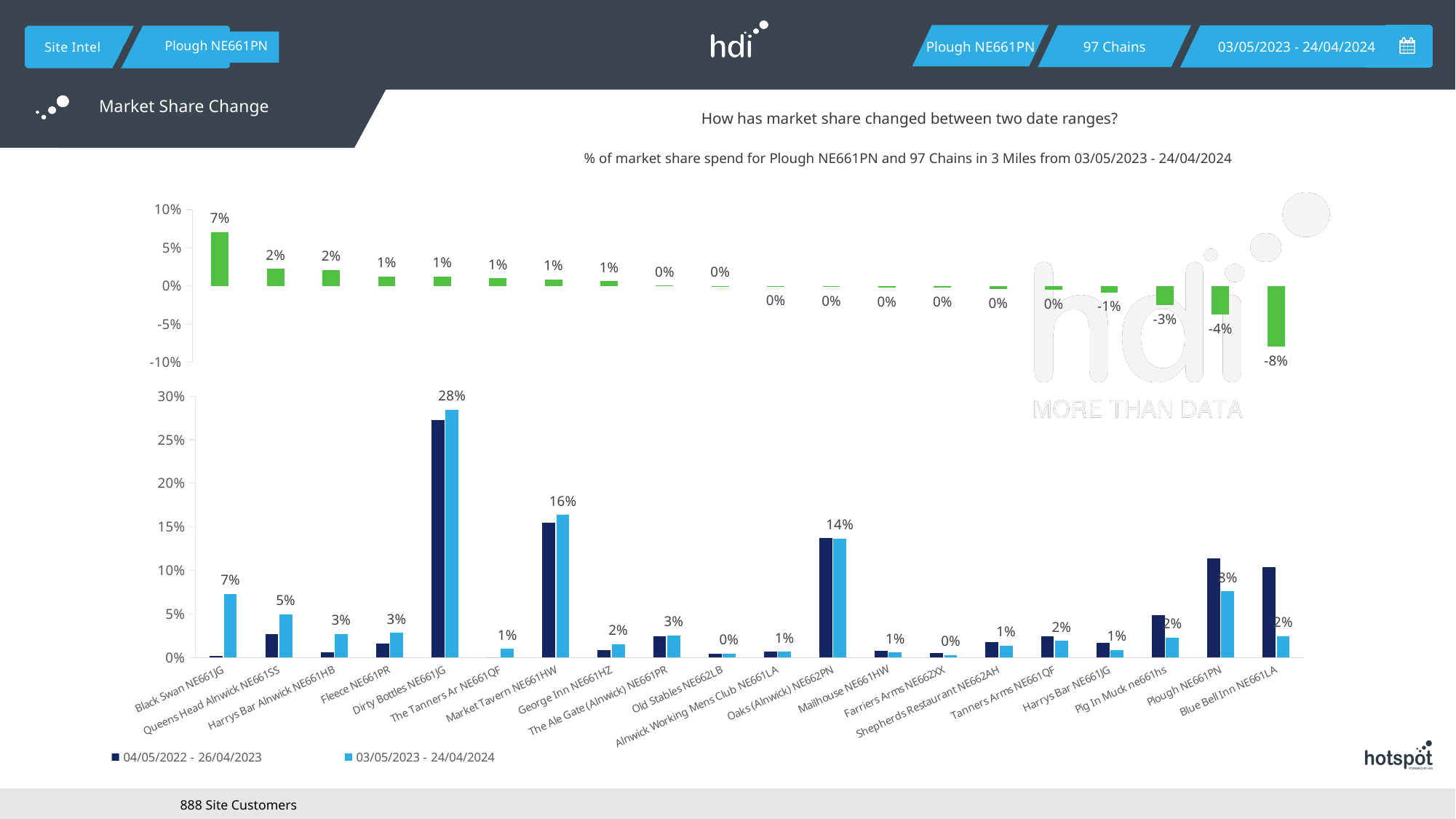
In the bottom chart, is the 04/05/2022 - 26/04/2023 value for Plough NE661PN greater or less than 10%? greater In the top chart, what is the value of the leftmost bar? 7% In the bottom chart, which is larger for Plough NE661PN: the 04/05/2022 - 26/04/2023 value or the 03/05/2023 - 24/04/2024 value? 04/05/2022 - 26/04/2023 How many series does the legend of the bottom chart list? 2 How many categories are shown on the x axis of the bottom chart? 20 In the bottom chart, what is the value for Oaks (Alnwick) NE662PN in the 03/05/2023 - 24/04/2024 series? 14% In the bottom chart, which category has the highest value in the 03/05/2023 - 24/04/2024 series? Dirty Bottles NE661JG In the bottom chart, what is the value for Market Tavern NE661HW in the 03/05/2023 - 24/04/2024 series? 16% In the top chart, what is the difference between the leftmost bar (7%) and the rightmost bar (-8%)? 15 percentage points What kind of chart is the bottom chart? bar chart In the top chart, what is the value of the rightmost bar? -8% In the bottom chart, what is the value for Dirty Bottles NE661JG in the 03/05/2023 - 24/04/2024 series? 28%